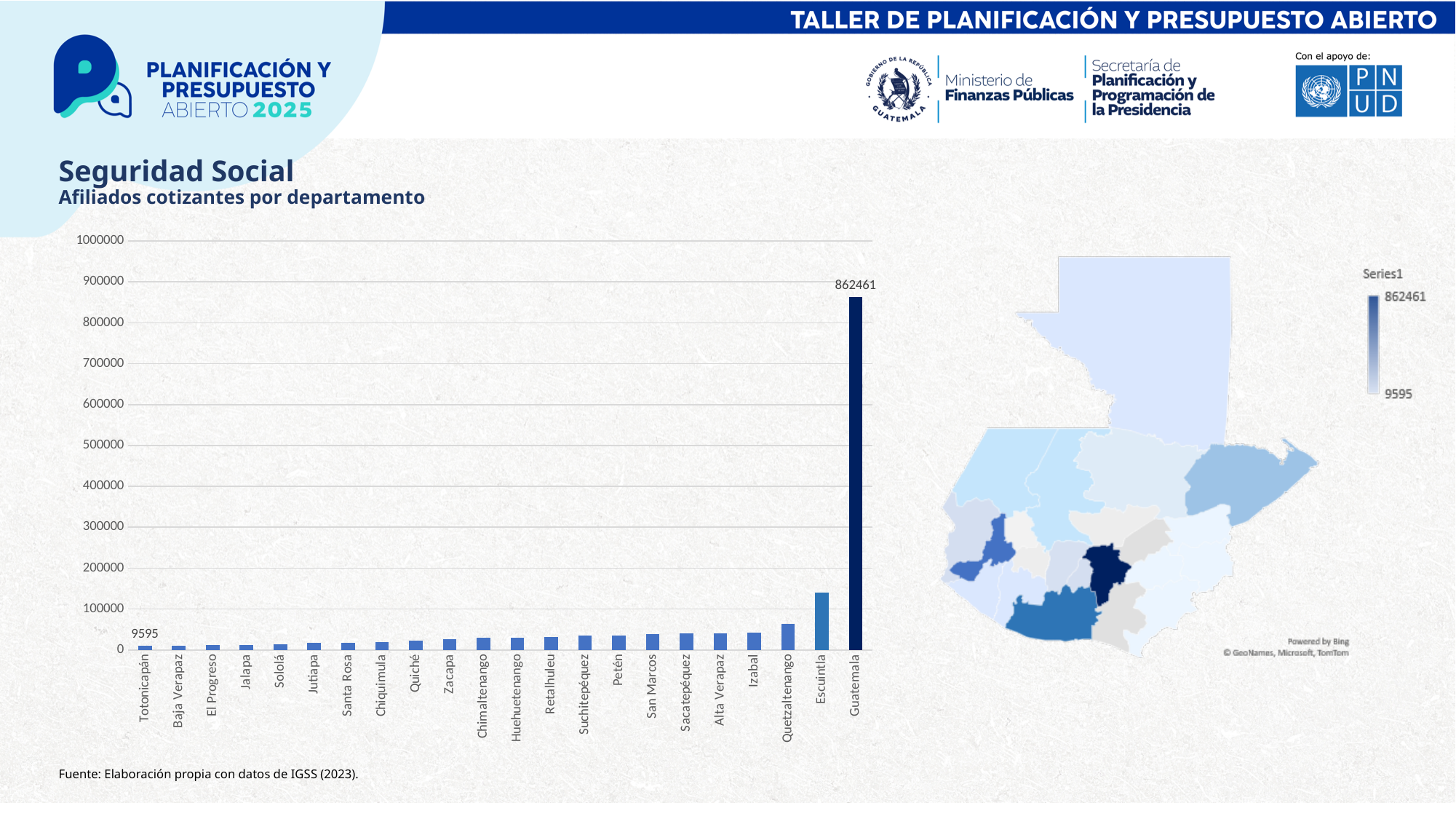
How many departments are shown on the bar chart? 22 On the bar chart, which department has the lowest number of afiliados cotizantes? Totonicapán On the bar chart, is the value for Quetzaltenango greater or less than 100000? less On the bar chart, what is the difference between the values for Guatemala and Totonicapán? 852866 On the bar chart, is the value for Escuintla greater or less than 100000? greater What kind of chart is the chart on the left of the slide? Bar chart On the bar chart, which has a larger value, Escuintla or Quetzaltenango? Escuintla On the bar chart, which department has the highest number of afiliados cotizantes? Guatemala On the bar chart, do the values rise or fall from left to right along the x axis? Rise On the bar chart, what is the value for Totonicapán? 9595 On the bar chart, what is the value for Guatemala? 862461 What is the subtitle of the chart on the slide? Afiliados cotizantes por departamento